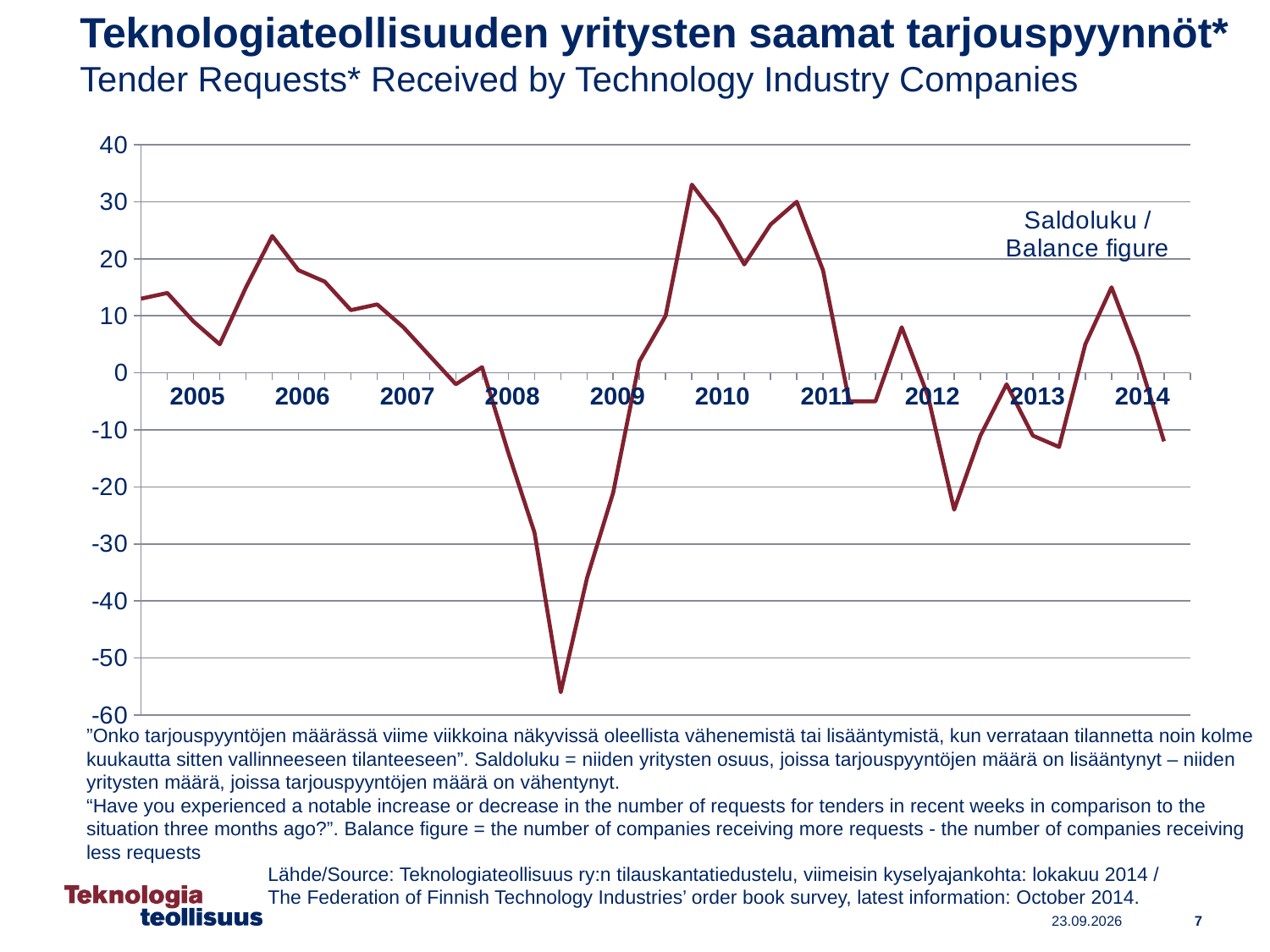
Does the line rise or fall from its 2013 peak to the end of 2014? fall What kind of chart is shown on the slide? line chart What is the name of the series shown in the chart? Saldoluku / Balance figure Is the last plotted value in 2014 greater or less than 0? less Is the lowest point of the line, reached between 2008 and 2009, greater or less than -50? less How many series does the chart show? 1 How many year labels are shown on the x axis? 10 Is the low point of the line in 2012 greater or less than -20? less Which is lower, the trough of the line between 2008 and 2009 or the trough in 2012? the trough between 2008 and 2009 What is the first year labelled on the x axis? 2005